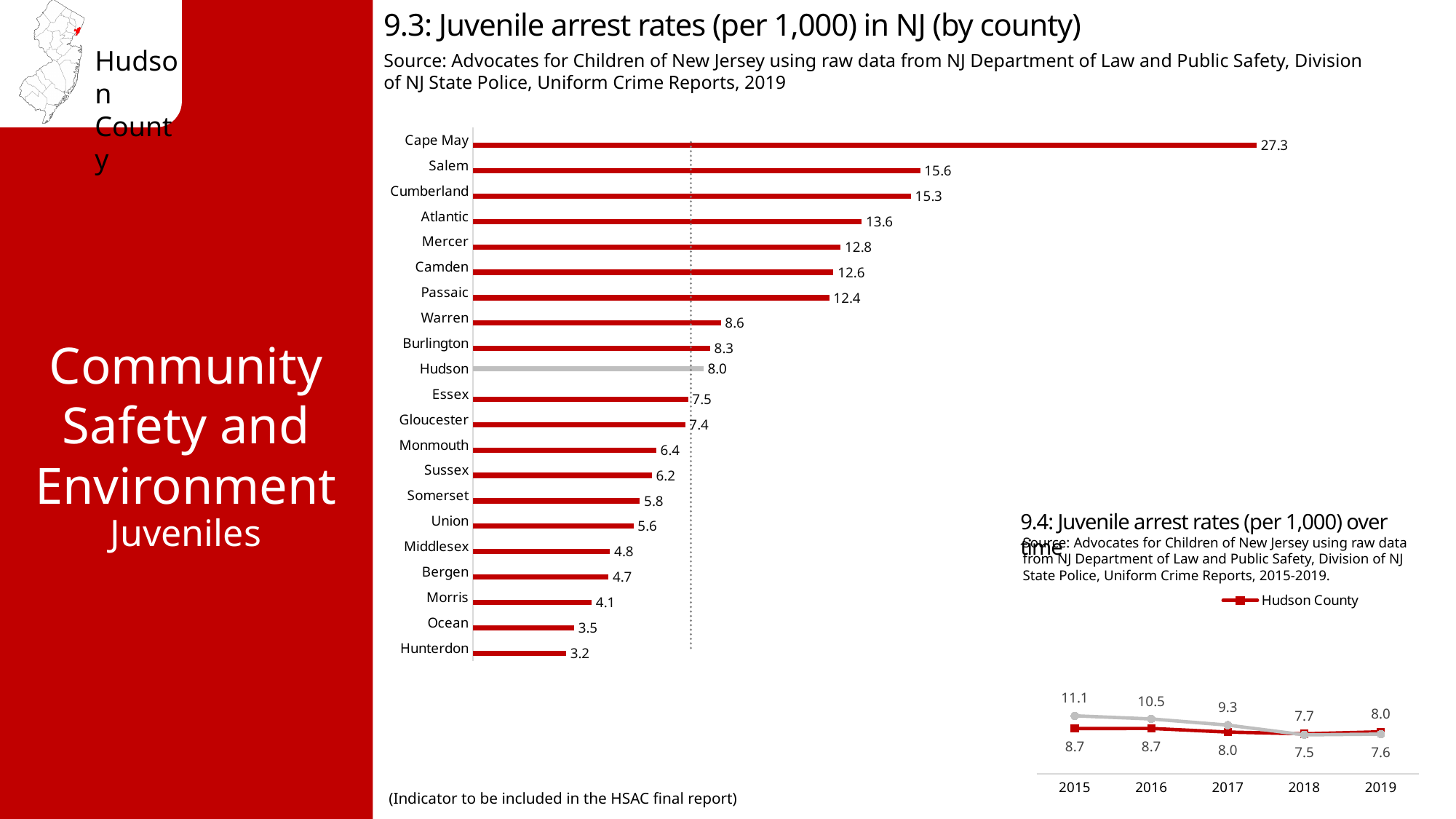
In chart 9.3, which county has the lowest juvenile arrest rate? Hunterdon In chart 9.3, what is the juvenile arrest rate for Passaic? 12.4 In chart 9.3, what is the juvenile arrest rate for Cape May? 27.3 In chart 9.3, what is the juvenile arrest rate for Hudson? 8.0 In chart 9.3, how many counties are shown? 21 In chart 9.3, which county has the highest juvenile arrest rate? Cape May What type of chart is chart 9.3? Bar chart In chart 9.3, what is the difference between the rates for Salem and Cumberland? 0.3 In chart 9.3, what is the difference between the rates for Cape May and Hudson? 19.3 In chart 9.4, how many years are shown on the x axis? 5 In chart 9.4, what series name is shown in the legend? Hudson County In chart 9.3, which has a higher juvenile arrest rate, Warren or Burlington? Warren